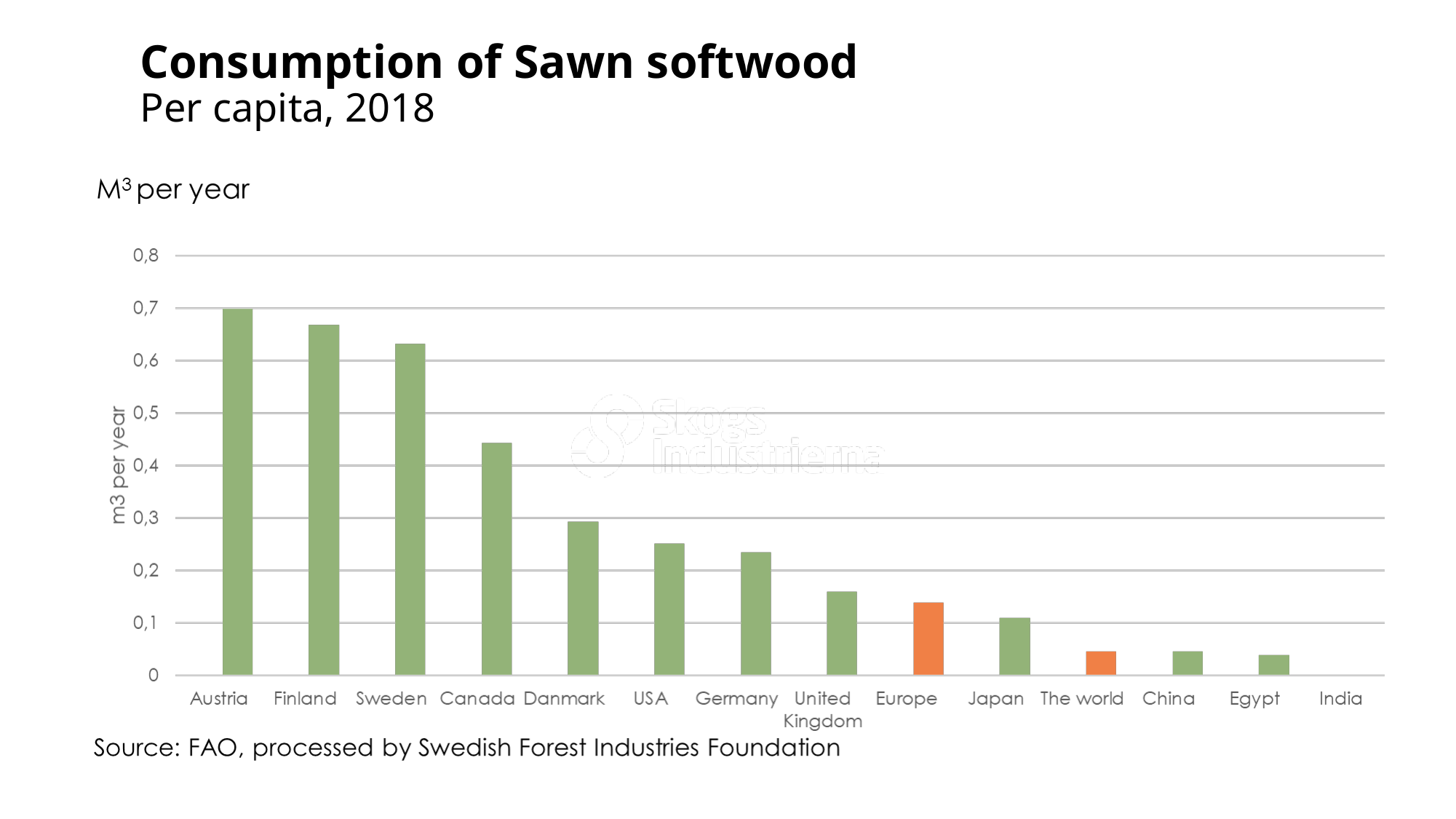
Which is larger, the value for Europe or the value for The world? Europe What kind of chart is shown on the slide? bar chart How many categories are shown on the x axis of the chart? 14 Which two categories are shown with orange bars instead of green? Europe and The world Is the value for The world greater or less than 0,1? less Which category has the highest per capita consumption of sawn softwood? Austria Is the value for Sweden greater or less than 0,6? greater Which category has the lowest per capita consumption of sawn softwood? India Is the value for Canada greater or less than 0,4? greater Which is larger, the value for Finland or the value for Sweden? Finland Do the values rise or fall moving from left to right along the x axis? fall